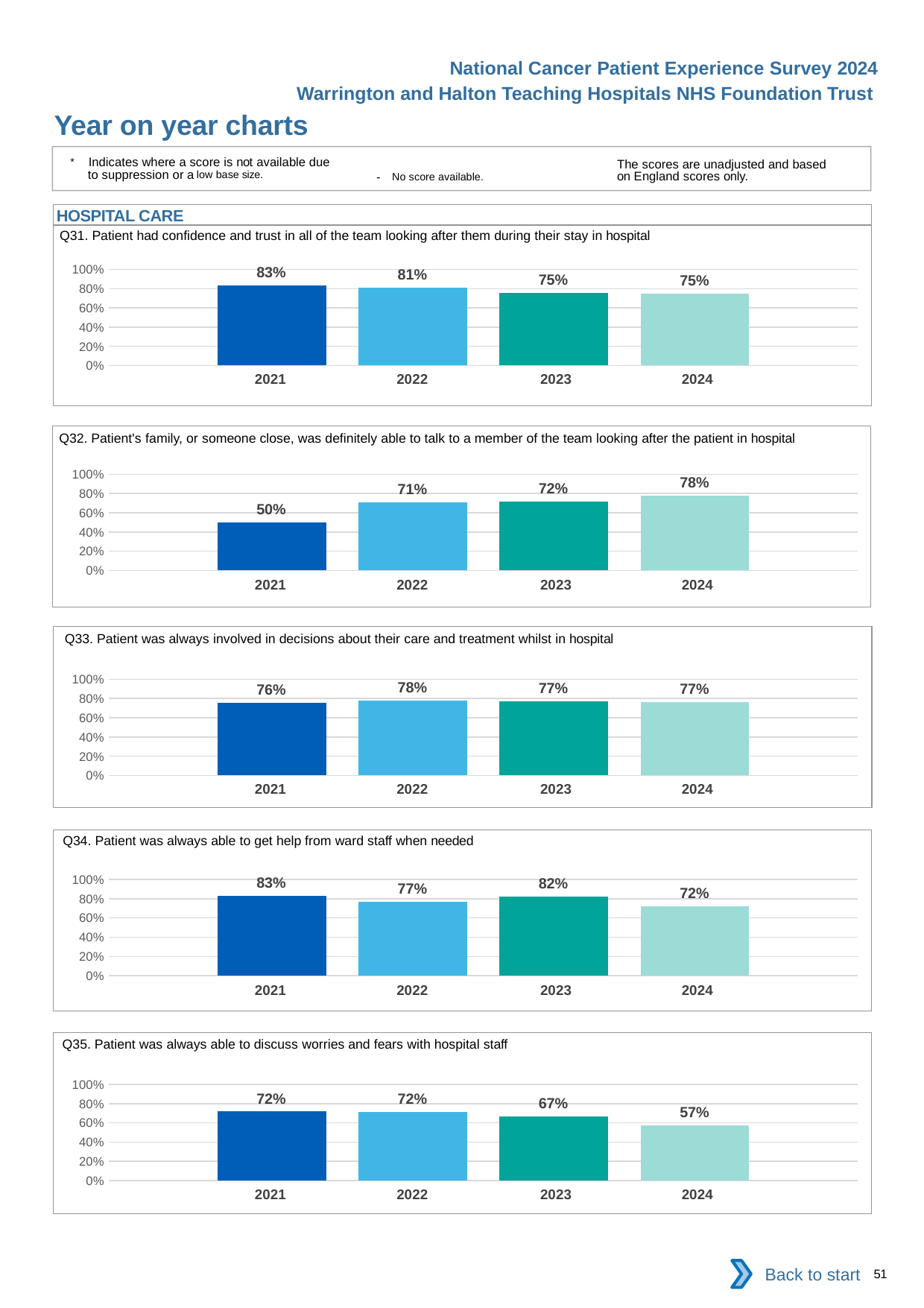
In the Q35 chart, what is the value for 2023? 67% In the Q34 chart, what is the value for 2024? 72% In the Q32 chart, what is the difference between the 2024 value and the 2021 value? 28% In the Q31 chart, how many years are shown on the x axis? 4 In the Q32 chart, which year has the lowest value? 2021 In the Q31 chart, what is the value for 2021? 83% In the Q34 chart, is the value for 2021 larger or smaller than the value for 2022? larger In the Q35 chart, do the values rise or fall from 2022 to 2024? fall How many charts are shown on the slide? 5 What kind of chart is the Q32 chart? bar chart In the Q35 chart, what is the difference between the 2021 value and the 2024 value? 15% In the Q33 chart, which year has the highest value? 2022